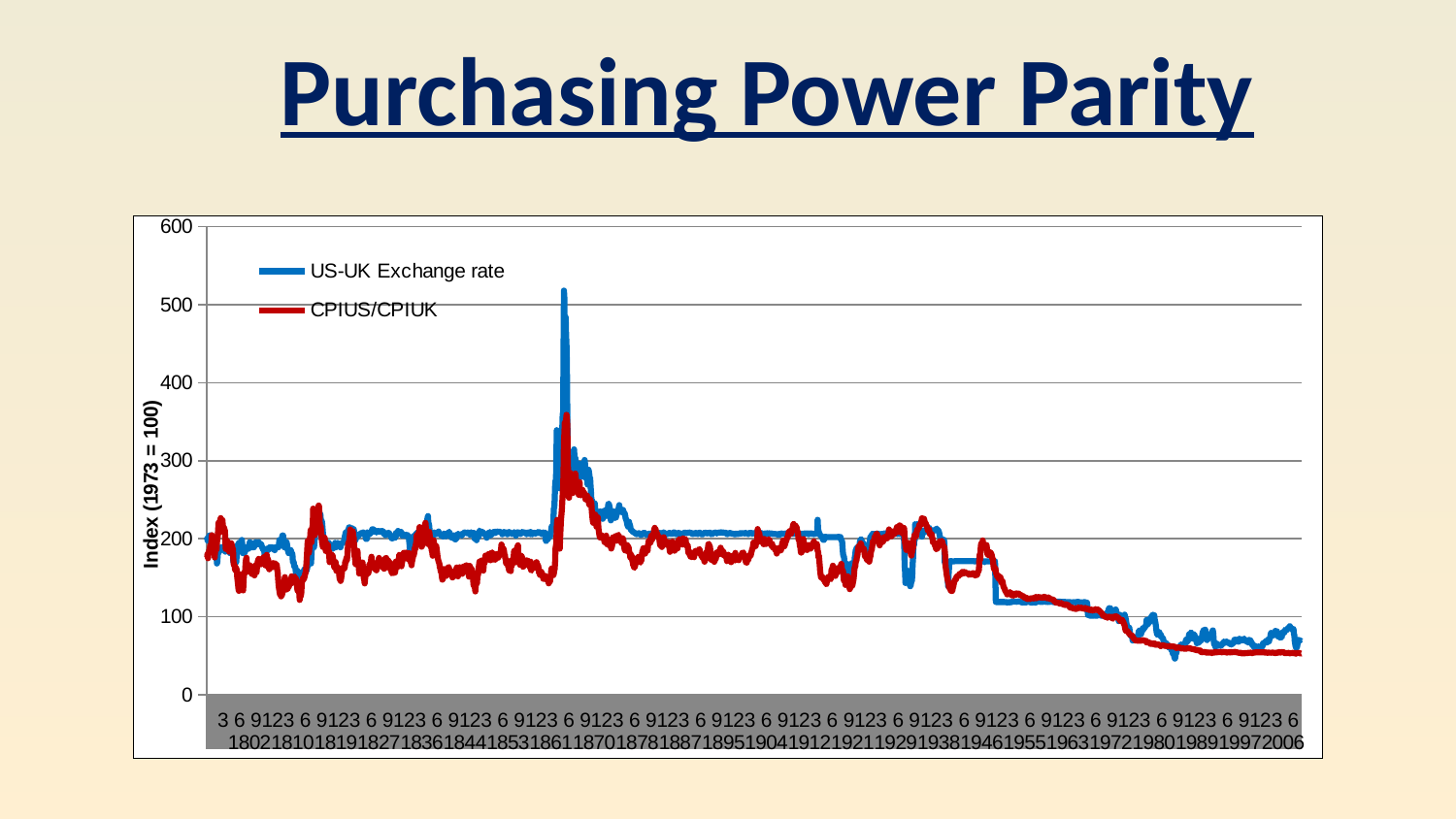
How many series does the legend list? 2 Which series is drawn in blue? US-UK Exchange rate What is the label on the vertical axis? Index (1973 = 100) Is the highest peak of the US-UK Exchange rate series greater or less than 400? greater Is the highest peak of the CPIUS/CPIUK series greater or less than 400? less What kind of chart is shown on the slide? line chart Is the value of the CPIUS/CPIUK series at the right end of the chart (around 2006) greater or less than 100? less Which series reaches the higher peak, US-UK Exchange rate or CPIUS/CPIUK? US-UK Exchange rate What is the title of the slide's chart? Purchasing Power Parity Overall, do the plotted values rise or fall from the left of the x axis to the right? fall